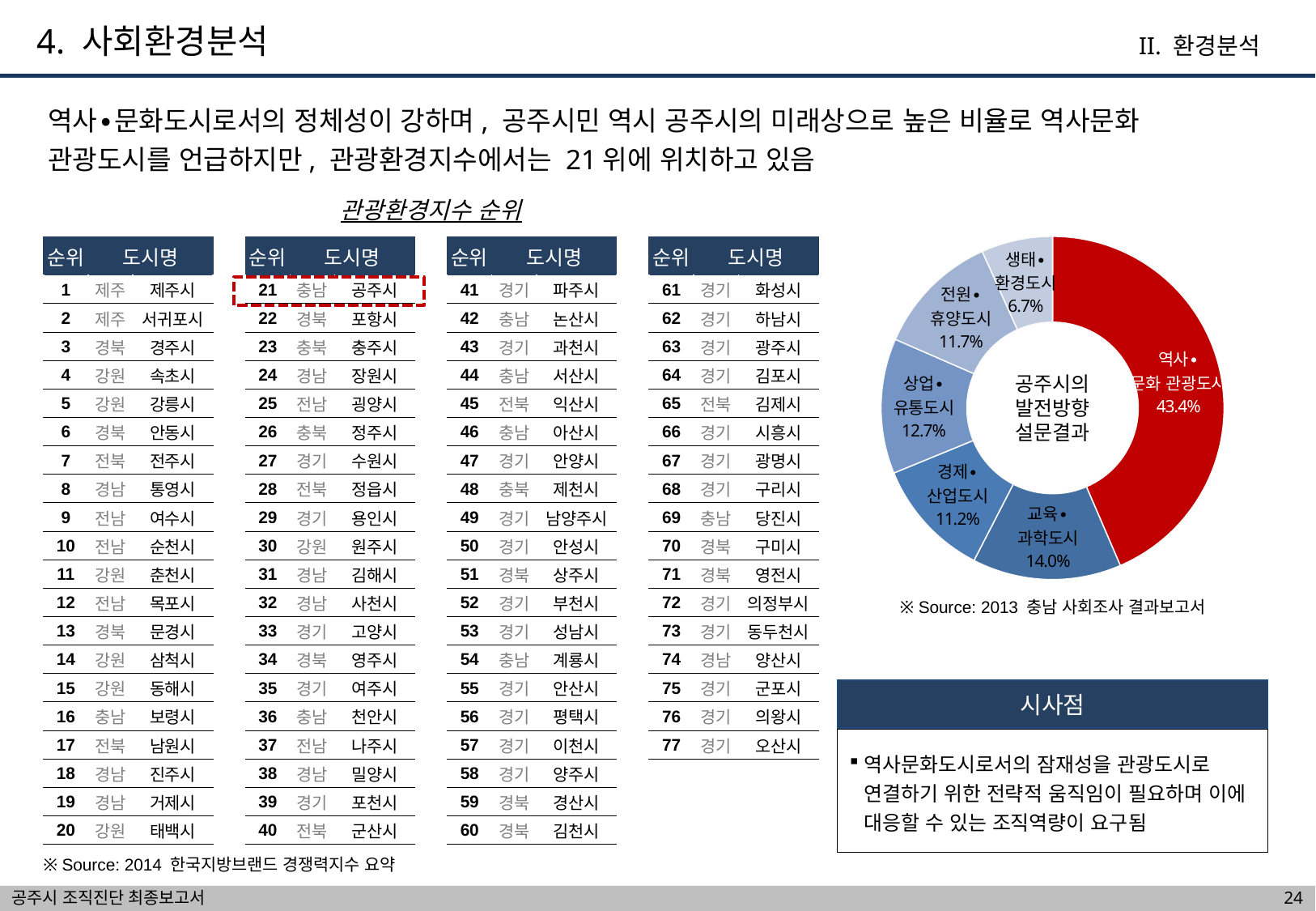
In the doughnut chart, what share is shown for 상업•유통도시? 12.7% What kind of chart is shown on the right side of the slide? Doughnut (pie) chart In the doughnut chart, what share is shown for 역사•문화 관광도시? 43.4% How many categories are shown in the doughnut chart? 6 In the doughnut chart, which is larger: 상업•유통도시 or 전원•휴양도시? 상업•유통도시 What is the difference between the shares of 전원•휴양도시 and 경제•산업도시 in the doughnut chart? 0.5% In the doughnut chart, what share is shown for 교육•과학도시? 14.0% What is the difference between the shares of 역사•문화 관광도시 and 교육•과학도시 in the doughnut chart? 29.4% Which category has the largest share in the doughnut chart? 역사•문화 관광도시 What text is shown in the centre of the doughnut chart? 공주시의 발전방향 설문결과 In the doughnut chart, what share is shown for 생태•환경도시? 6.7% Which category has the smallest share in the doughnut chart? 생태•환경도시